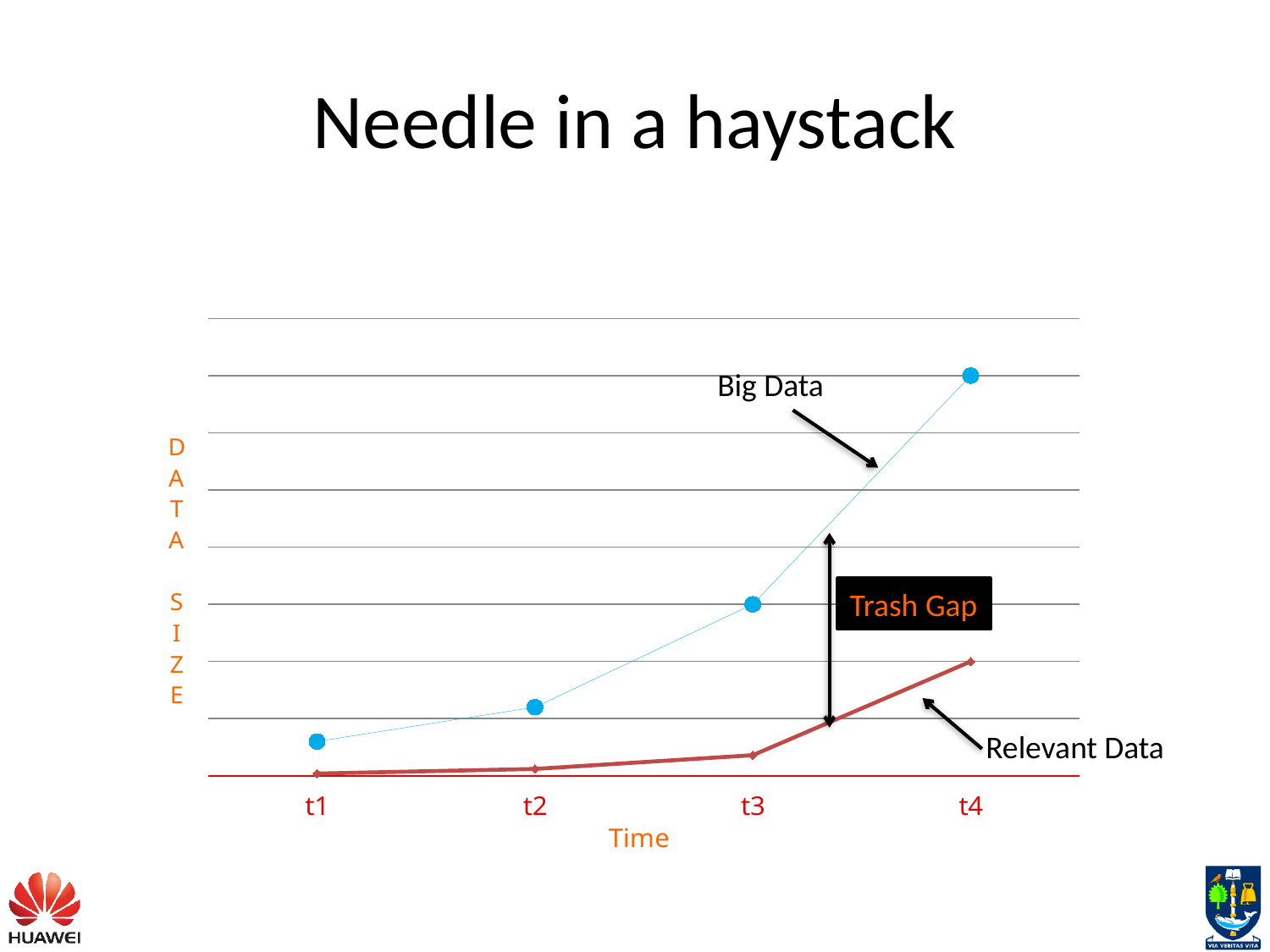
At t4, which series has the larger value, Big Data or Relevant Data? Big Data At which time point does the Big Data series reach its highest value? t4 At t3, which series is higher, Big Data or Relevant Data? Big Data What kind of chart is shown on the slide? line chart How many time points are plotted along the x axis? 4 At which time point is the Relevant Data series lowest? t1 Does the Relevant Data series rise or fall from t1 to t4? rise What is the label on the x axis of the chart? Time How many data series are plotted on the chart? 2 Does the Big Data series rise or fall from t1 to t4? rise What label is given to the gap between the two lines on the chart? Trash Gap